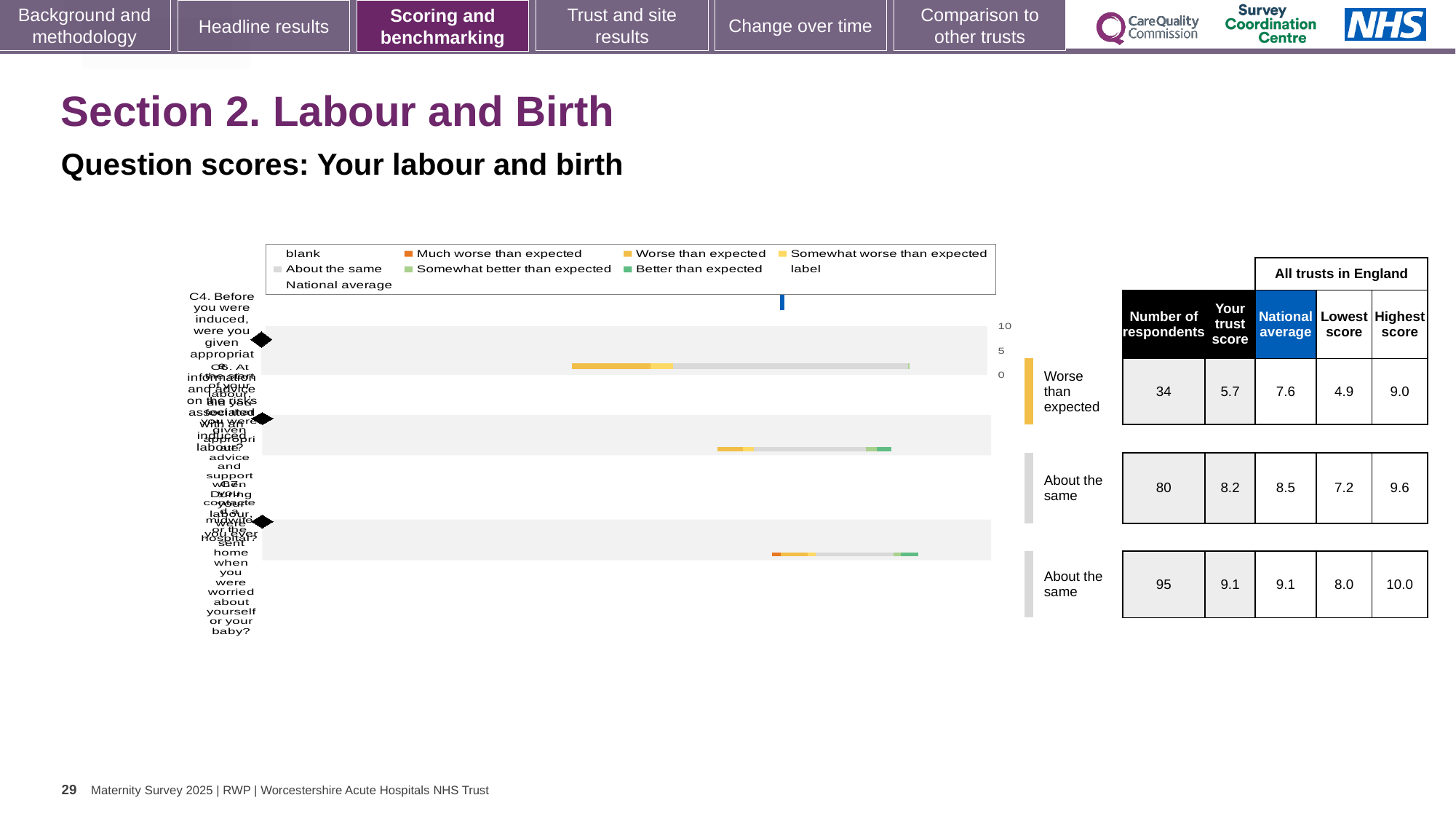
Which row has the highest number of respondents? the third row (95) In the table, what is the number of respondents for the first row, rated 'Worse than expected'? 34 In the table, what is the trust score for the first row, rated 'Worse than expected'? 5.7 What colour does the legend use for 'Better than expected'? green What kind of chart is shown on the slide? bar chart How many question rows (bars) are plotted in the chart? 3 In the table, what is the lowest score for the third row (95 respondents)? 8.0 For the first row, what is the difference between the national average and the trust score? 1.9 In the table, what is the national average for the first row, rated 'Worse than expected'? 7.6 For the second row, which is larger: the trust score or the national average? national average For the third row, what is the difference between the highest score and the lowest score? 2.0 In the table, what is the highest score for the second row (80 respondents)? 9.6